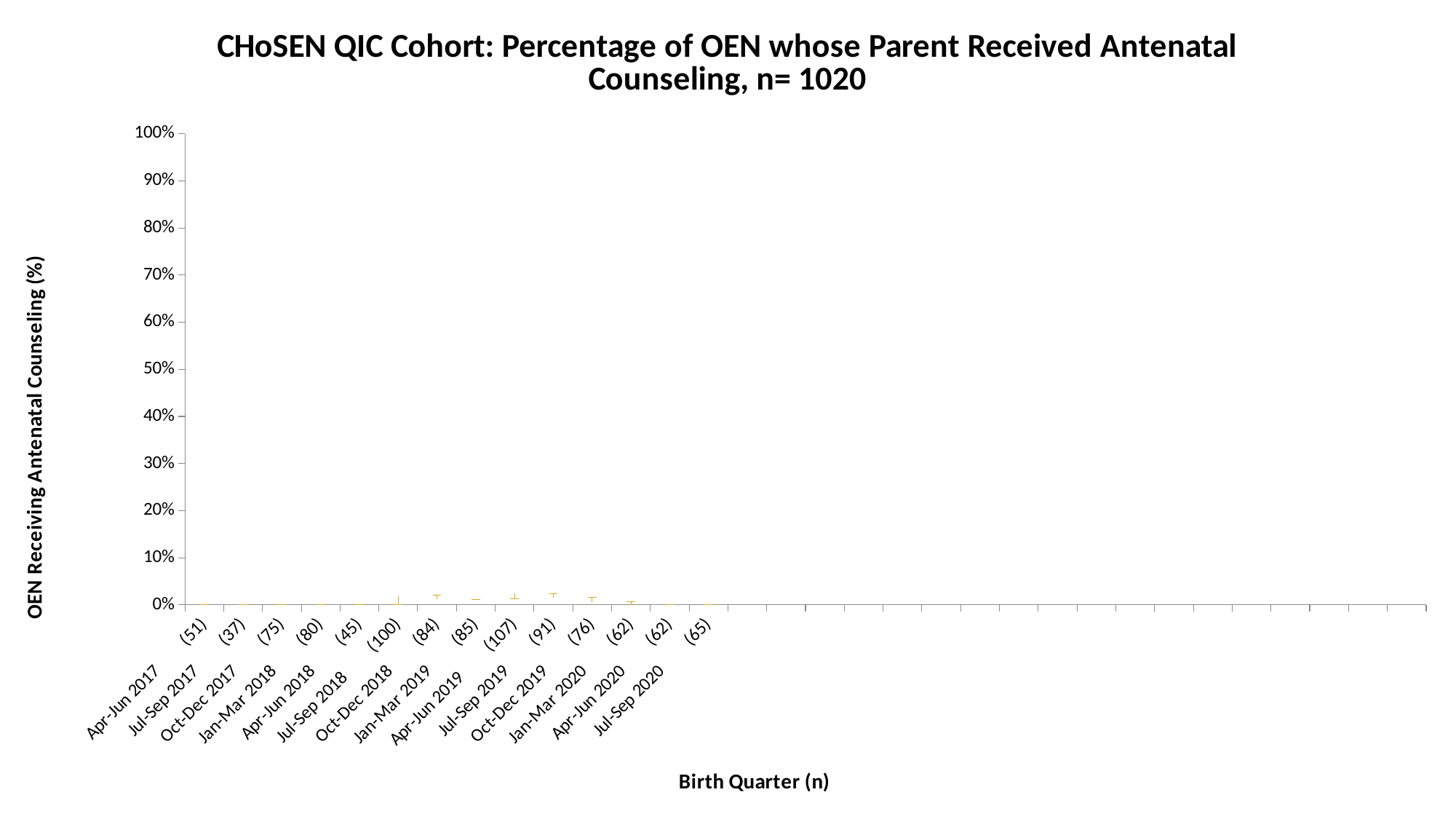
What kind of chart is shown on the slide? line chart What is the n shown for the Oct-Dec 2018 birth quarter? 84 Is the value for Jul-Sep 2019 greater or less than 20%? less What is the total n stated in the chart title? 1020 How many birth quarters are shown along the x axis? 14 Is the value for Jan-Mar 2019 greater or less than 10%? less What is the label of the x axis? Birth Quarter (n) What is the n shown for the Jul-Sep 2020 birth quarter? 65 What is the n shown for the Jul-Sep 2017 birth quarter? 37 What is the n shown for the Jul-Sep 2019 birth quarter? 91 What is the title of the chart? CHoSEN QIC Cohort: Percentage of OEN whose Parent Received Antenatal Counseling, n= 1020